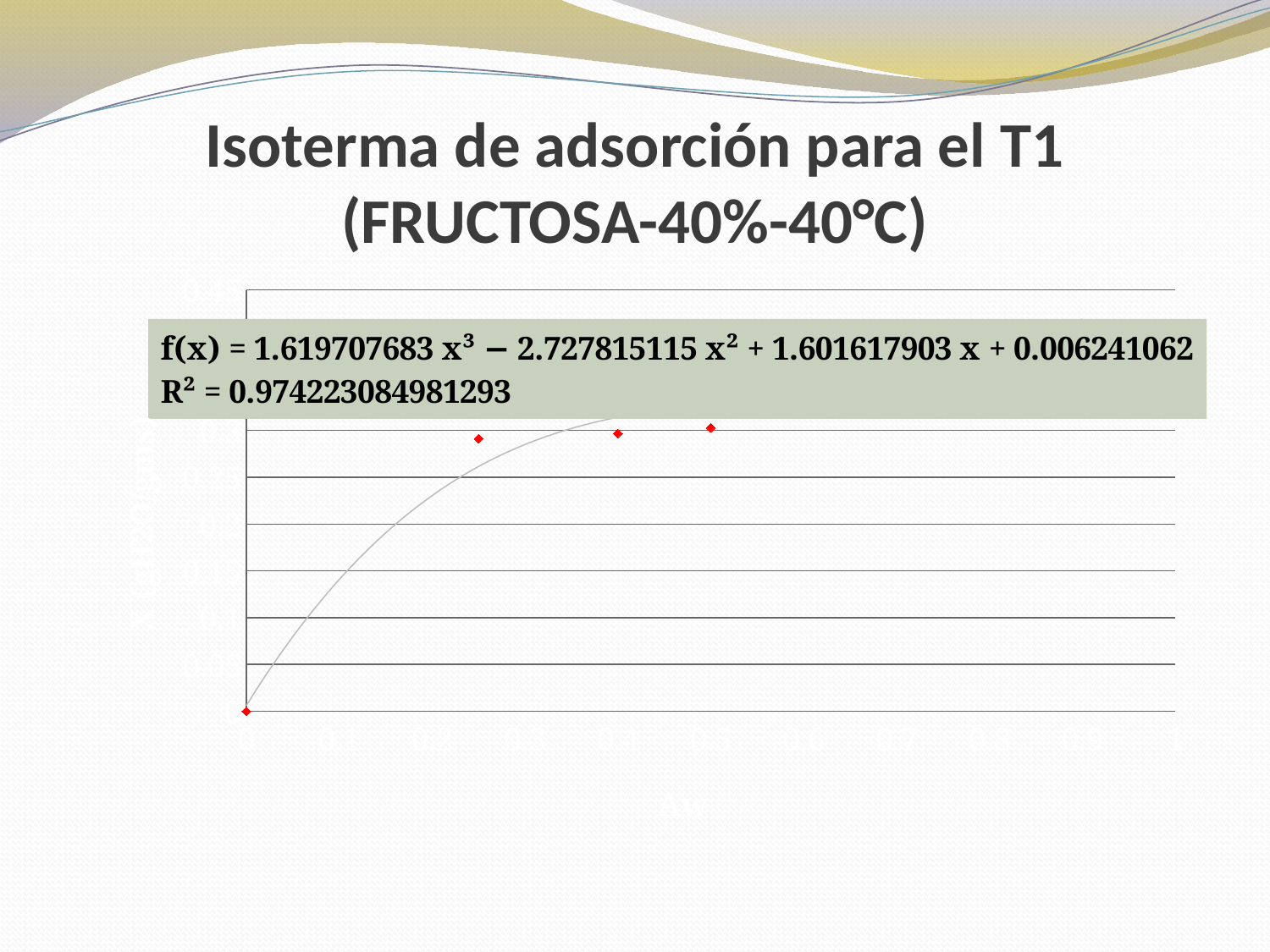
What is the R² value shown for the fitted curve? 0.974223084981293 Is the plotted value at Aw = 0.5 greater or less than 0.2? greater Is the plotted value at Aw = 0.4 greater or less than 0.4? less What is the title of the chart on the slide? Isoterma de adsorción para el T1 (FRUCTOSA-40%-40°C) Which is larger, the plotted value at Aw = 0 or at Aw = 0.4? Aw = 0.4 At which Aw value is the lowest plotted point? 0 What is the plotted value at Aw = 0? 0 What is the label of the x axis? Aw Is the plotted value at Aw = 0.25 greater or less than 0.15? greater Do the plotted values rise or fall as Aw increases from 0 to 0.5? rise What kind of chart is shown on the slide? scatter chart